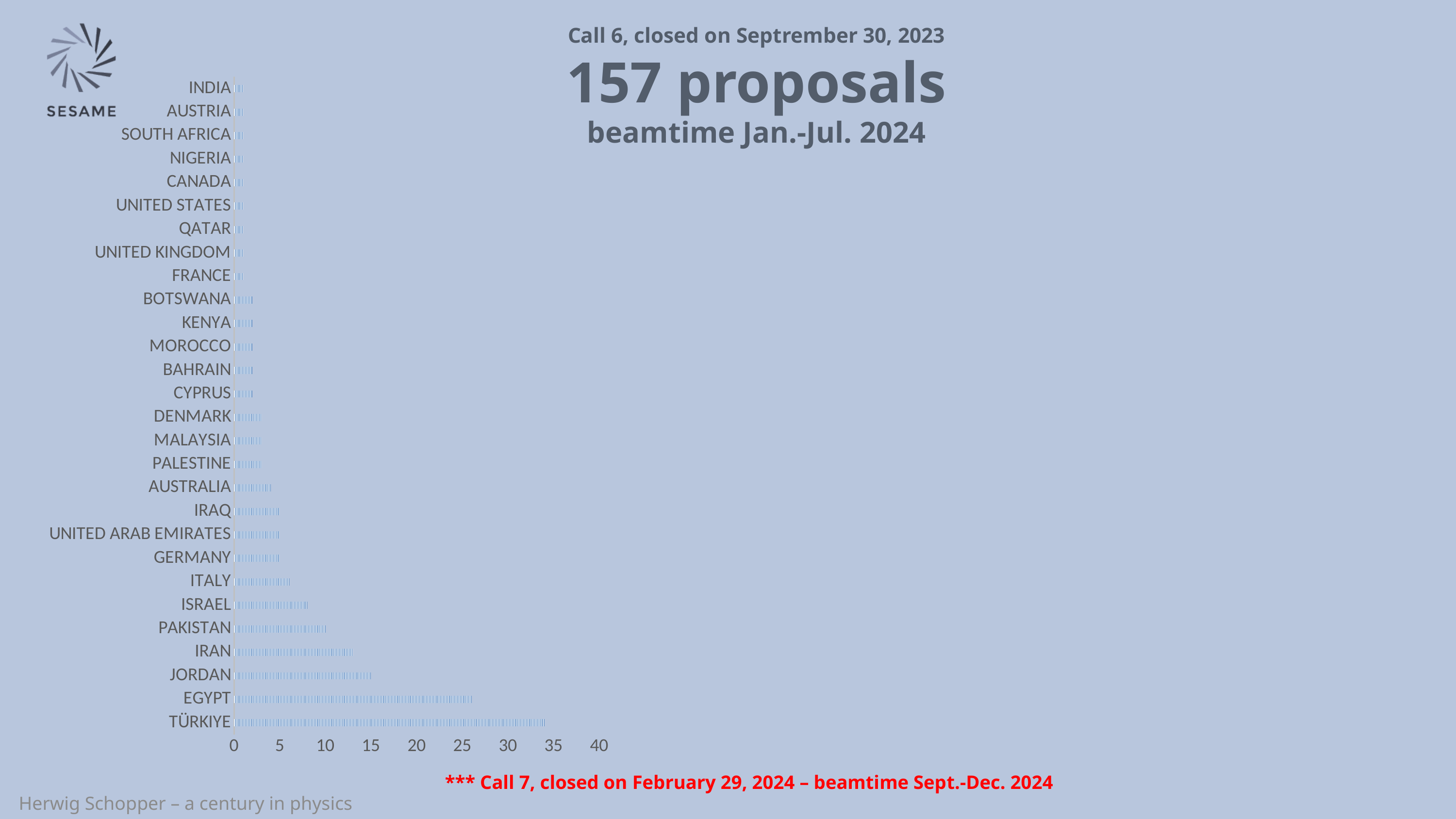
What is the total number of proposals stated in the slide heading? 157 proposals Which country has the highest number of proposals in the chart? TÜRKIYE How many countries are listed in the chart? 28 Is the value for ISRAEL greater or less than 10? less Is the value for JORDAN greater or less than 20? less Is the value for EGYPT greater or less than 20? greater What kind of chart is shown on the slide? bar chart Which has the larger value, JORDAN or ISRAEL? JORDAN Which has the larger value, TÜRKIYE or EGYPT? TÜRKIYE Which country has the second-longest bar in the chart? EGYPT